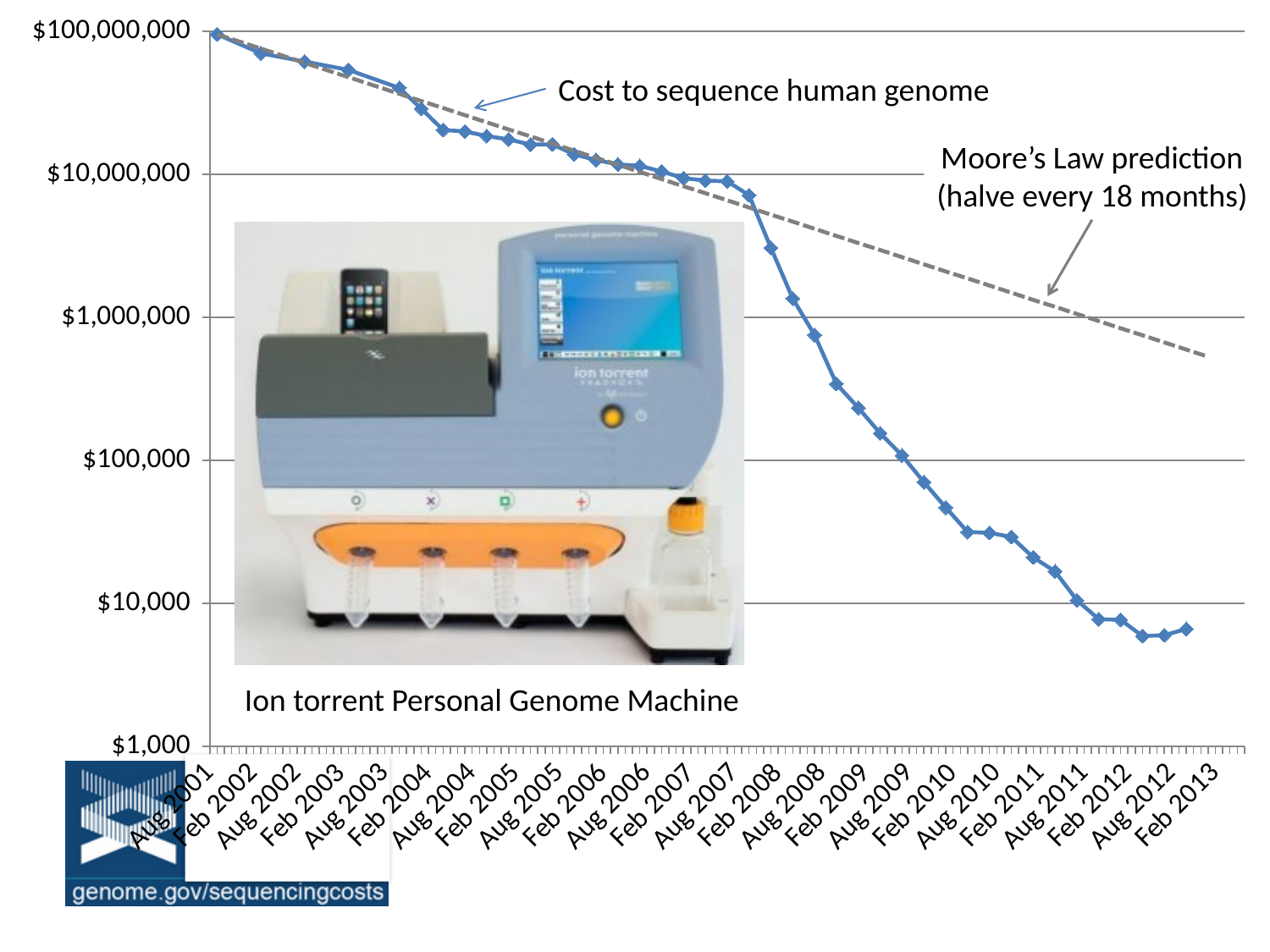
What does the dashed grey line on the chart represent? Moore's Law prediction (halve every 18 months) Is the cost to sequence a human genome in Feb 2004 greater or less than $10,000,000? greater At which x-axis date is the cost to sequence a human genome highest? Aug 2001 Is the cost to sequence a human genome in Feb 2013 greater or less than $10,000? less How many series are plotted on the chart? 2 Does the cost to sequence a human genome rise or fall from Aug 2001 to Feb 2013? fall What does the blue line with markers on the chart represent? Cost to sequence human genome Is the cost to sequence a human genome in Feb 2010 greater or less than $100,000? less How many date labels are shown on the x axis? 24 In Feb 2013, which is higher: the Moore's Law prediction or the actual cost to sequence a human genome? Moore's Law prediction What kind of chart is shown on the slide? line chart